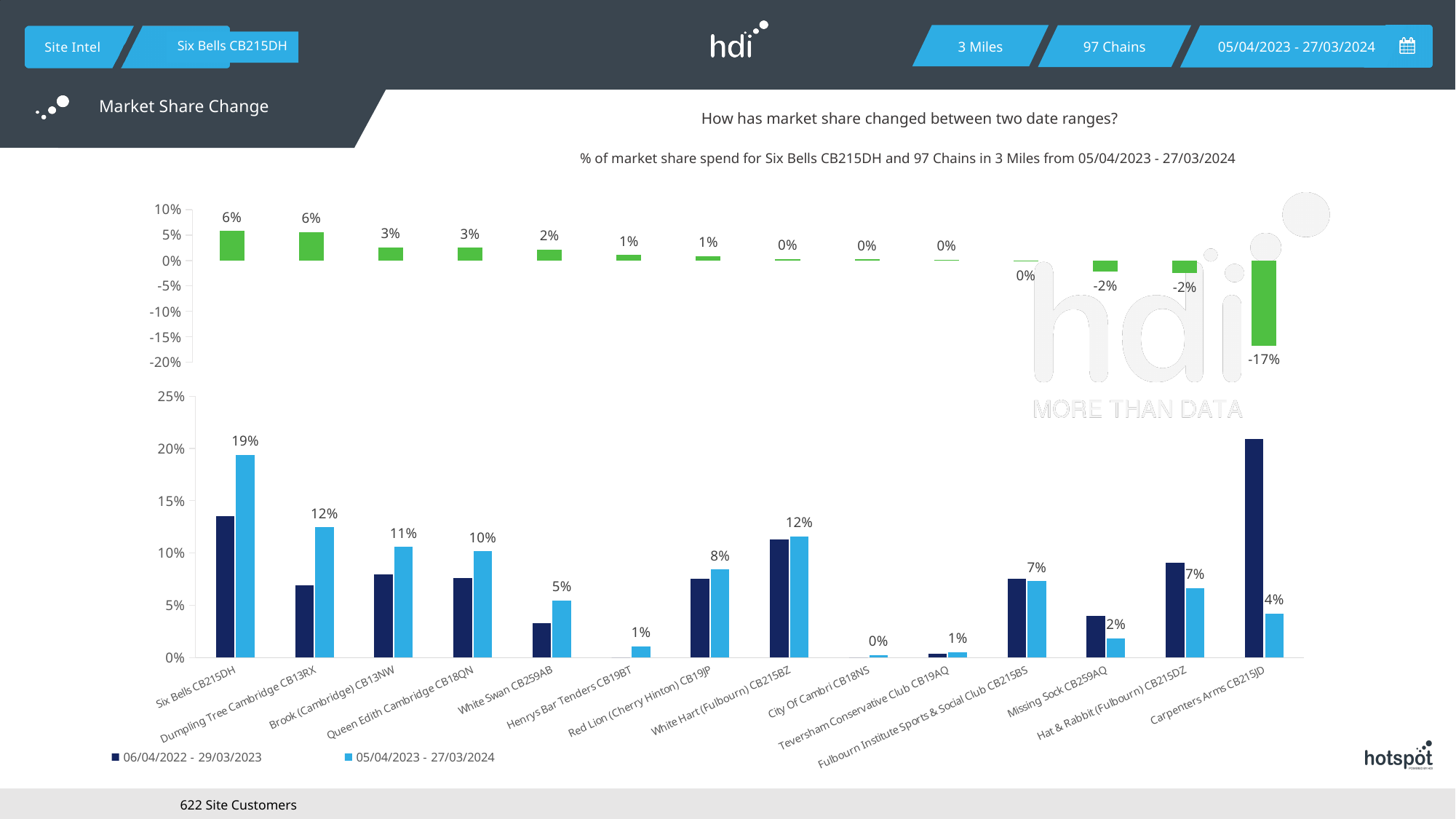
On the bottom chart, is the value for Carpenters Arms CB215JD in the 06/04/2022 - 29/03/2023 series greater or less than 15%? greater How many series does the legend of the bottom chart list? 2 What kind of chart is the bottom chart? bar chart How many categories are shown on the x axis of the bottom chart? 14 On the top chart (market share change), what is the value for Carpenters Arms CB215JD? -17% On the top chart (market share change), what is the difference between the values for Six Bells CB215DH and Brook (Cambridge) CB13NW? 3 percentage points On the bottom chart, which is larger in the 05/04/2023 - 27/03/2024 series: Six Bells CB215DH or Dumpling Tree Cambridge CB13RX? Six Bells CB215DH On the bottom chart, is the value for Dumpling Tree Cambridge CB13RX in the 06/04/2022 - 29/03/2023 series greater or less than 10%? less On the bottom chart, which category has the highest value in the 05/04/2023 - 27/03/2024 series? Six Bells CB215DH On the top chart (market share change), which category has the lowest value? Carpenters Arms CB215JD On the bottom chart, what is the value for White Hart (Fulbourn) CB215BZ in the 05/04/2023 - 27/03/2024 series? 12% On the bottom chart, what is the value for Six Bells CB215DH in the 05/04/2023 - 27/03/2024 series? 19%